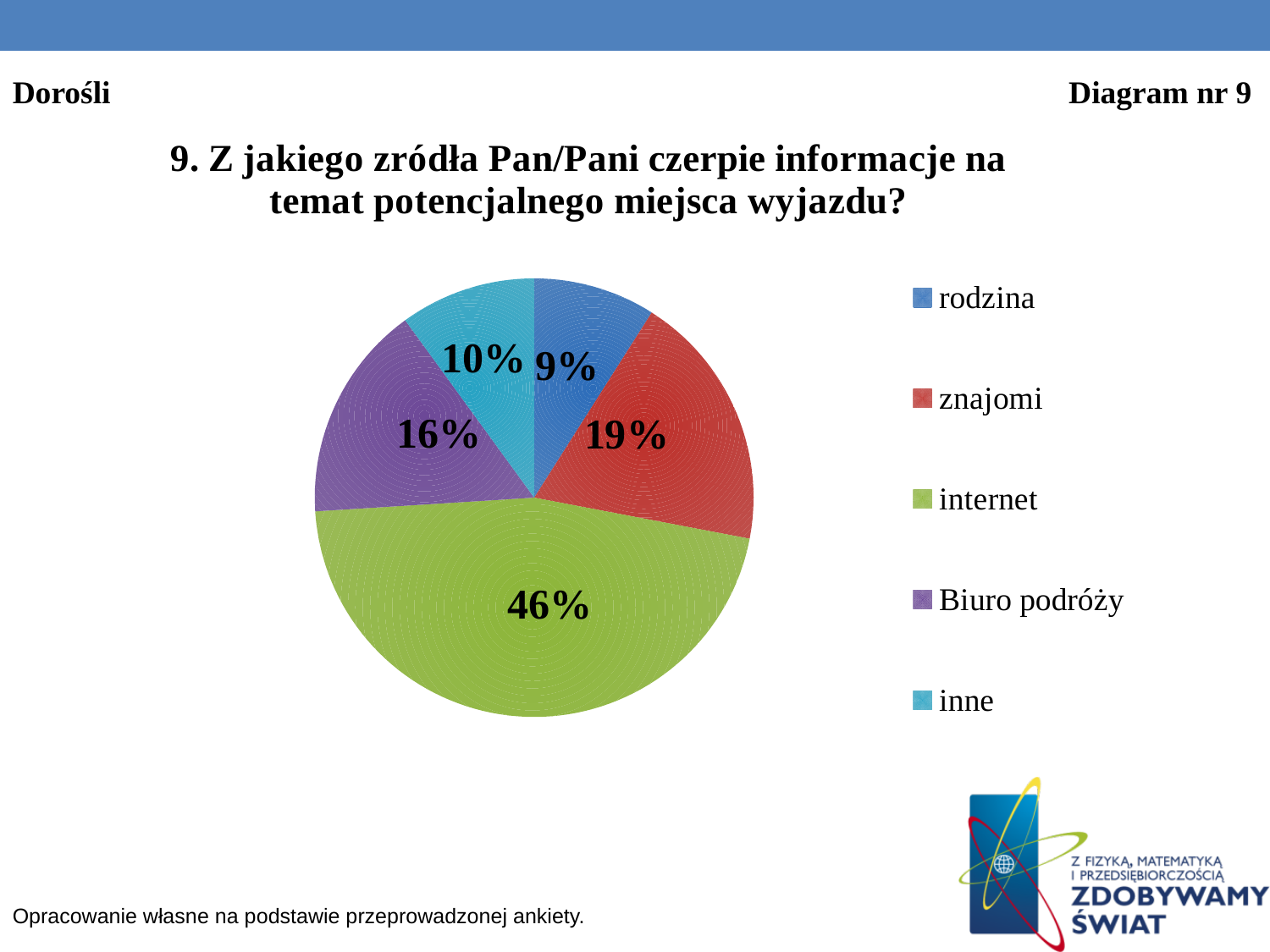
What percentage of the pie is labelled for rodzina? 9% What percentage of the pie is labelled for znajomi? 19% What is the difference in percentage points between the internet slice and the znajomi slice? 27 Which category has the smallest share of the pie? rodzina What percentage of the pie is labelled for Biuro podróży? 16% How many categories does the legend list? 5 What colour is the internet slice of the pie? green What percentage of the pie is labelled for inne? 10% Which slice is larger, Biuro podróży or inne? Biuro podróży What type of chart is shown on the slide? pie chart What percentage of the pie is labelled for internet? 46% Which category has the largest share of the pie? internet